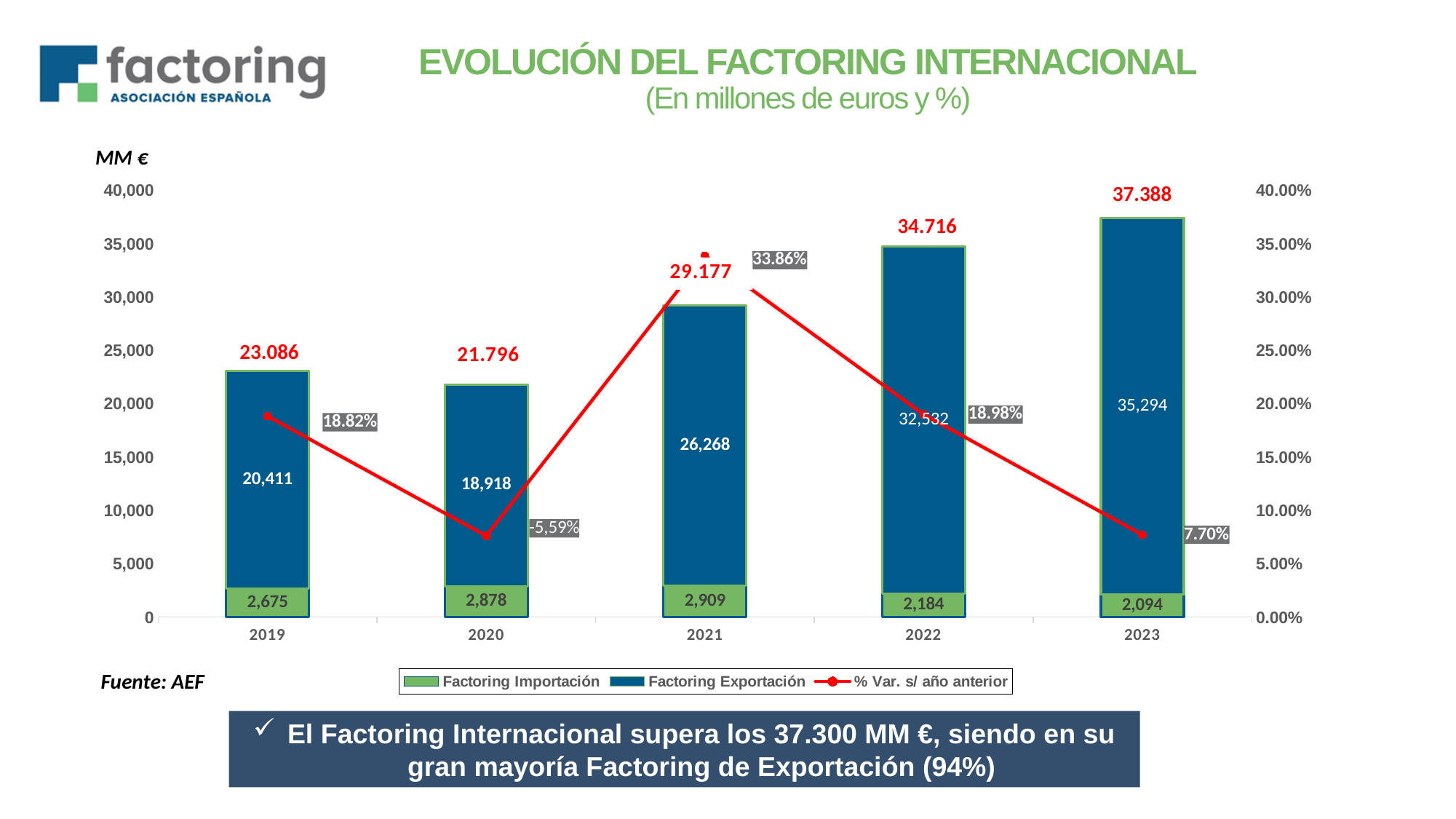
What is the total of the stacked bar for 2022? 34.716 How many series does the legend list? 3 Which year has the lowest Factoring Importación value? 2023 In which year is the % Var. s/ año anterior highest? 2021 What is the value of Factoring Exportación in 2021? 26,268 What is the difference between Factoring Exportación in 2023 and in 2022? 2,762 Does Factoring Exportación rise or fall from 2020 to 2023? rise How many years are shown on the x axis? 5 What is the % Var. s/ año anterior shown for 2020? -5,59% Which year has the highest Factoring Exportación value? 2023 Which year has the larger Factoring Importación value, 2020 or 2021? 2021 What is the value of Factoring Importación in 2019? 2,675